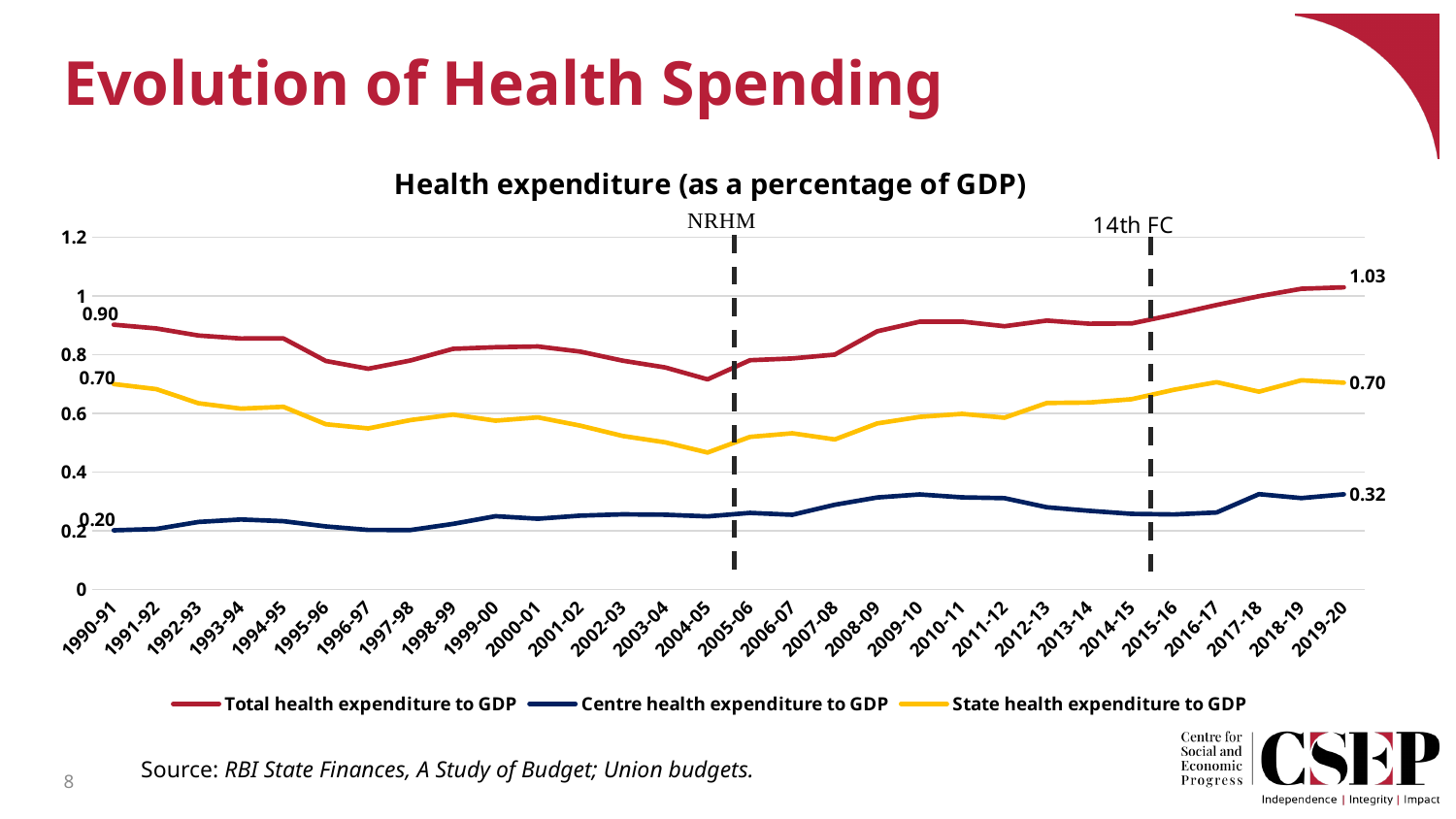
What kind of chart is shown on the slide? line chart What is the value of Total health expenditure to GDP in 1990-91? 0.90 What is the value of Centre health expenditure to GDP in 2019-20? 0.32 By how much did Total health expenditure to GDP change between 1990-91 and 2019-20? 0.13 What is the title of the chart? Health expenditure (as a percentage of GDP) What is the value of Centre health expenditure to GDP in 1990-91? 0.20 Which series has the highest value in 2019-20? Total health expenditure to GDP By how much did Centre health expenditure to GDP change between 1990-91 and 2019-20? 0.12 What is the value of Total health expenditure to GDP in 2019-20? 1.03 How many series does the legend list? 3 What is the value of State health expenditure to GDP in 2019-20? 0.70 Is the value of Total health expenditure to GDP in 2004-05 greater or less than 0.8? less